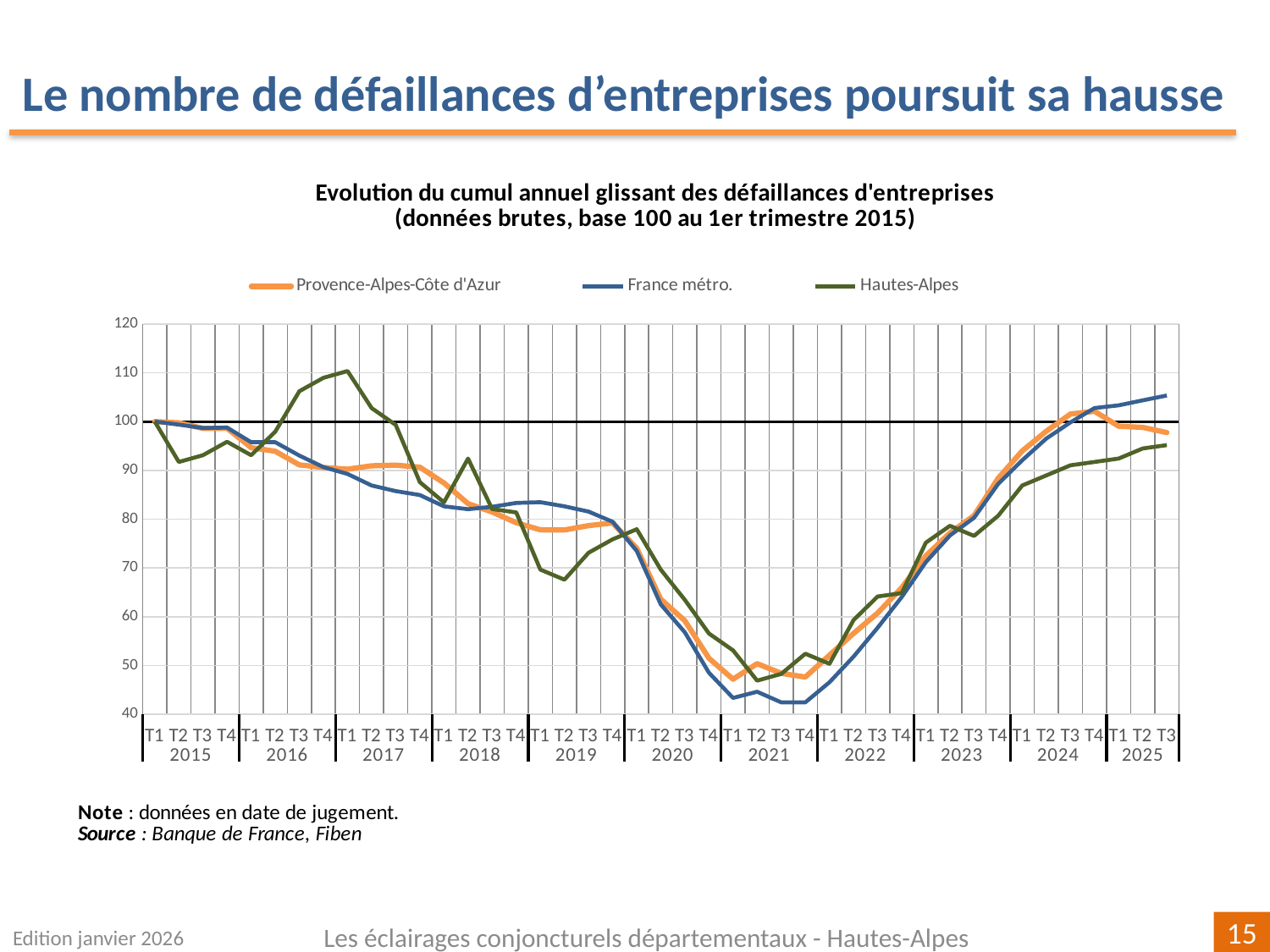
Does the France métro. series rise or fall between T1 2021 and T3 2025? rise How many years are labelled on the x axis? 11 Is the value for France métro. at T3 2025 greater or less than 100? greater How many series does the legend list? 3 At T3 2025, which series is higher: France métro. or Hautes-Alpes? France métro. Is the value for France métro. at T1 2021 greater or less than 50? less Which three series are listed in the legend? Provence-Alpes-Côte d'Azur, France métro., Hautes-Alpes What is the value of each series at T1 2015, the base period? 100 What kind of chart is shown on the slide? line chart Is the value for Hautes-Alpes at T3 2025 greater or less than 100? less Which series has the lowest value at T1 2021? France métro.